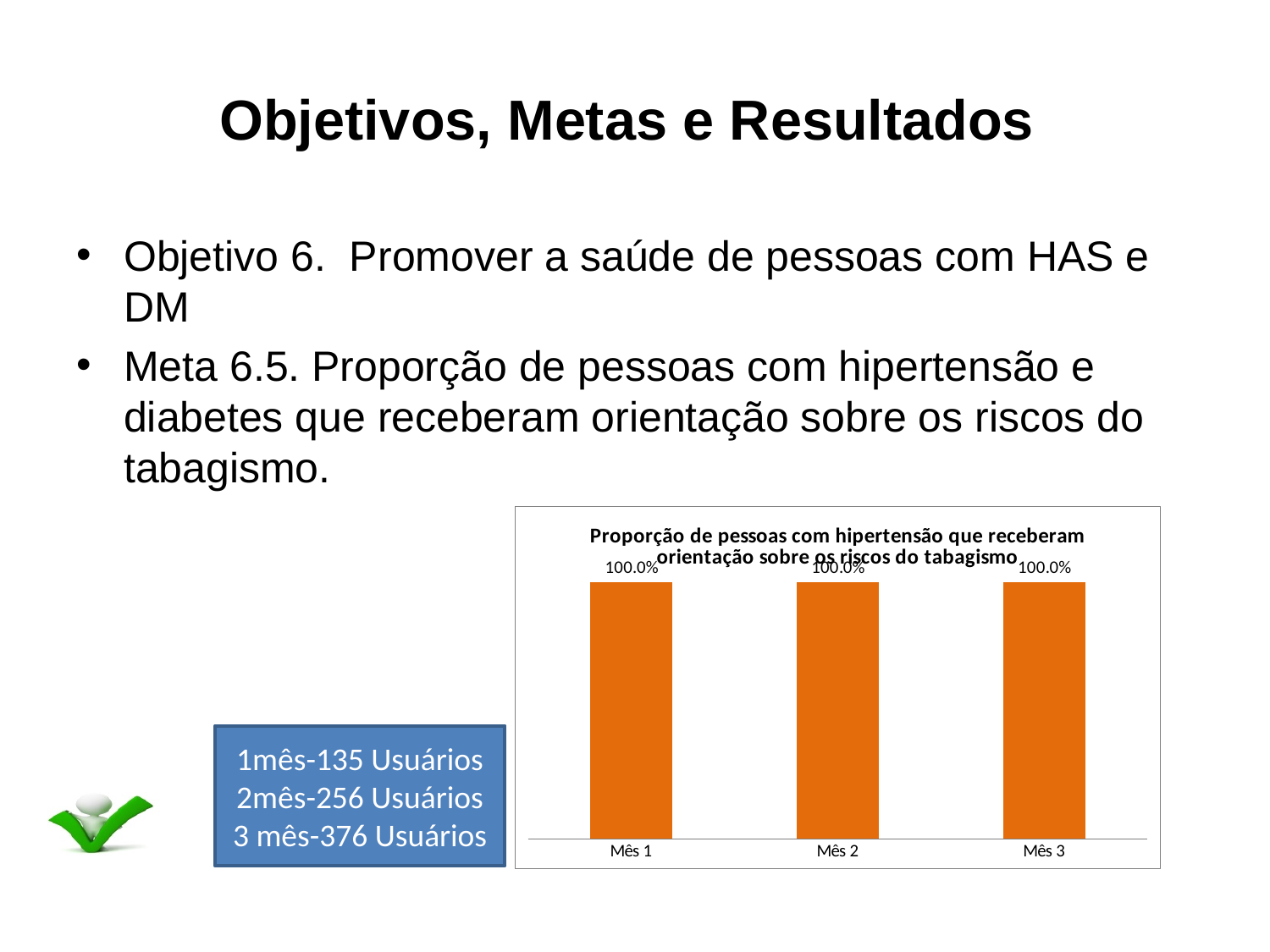
What kind of chart is shown on the slide? Bar chart How many categories (months) are plotted in the chart? 3 What is the value for Mês 3 in the chart? 100.0% Is the value for Mês 2 larger than, smaller than, or equal to the value for Mês 1? Equal What is the difference between the values for Mês 1 and Mês 3? 0.0% What is the label of the first category on the x axis of the chart? Mês 1 What is the title of the chart? Proporção de pessoas com hipertensão que receberam orientação sobre os riscos do tabagismo What is the value for Mês 2 in the chart? 100.0% Do the values rise, fall, or stay the same from Mês 1 to Mês 3? Stay the same What colour are the bars in the chart? Orange What is the value for Mês 1 in the chart? 100.0%